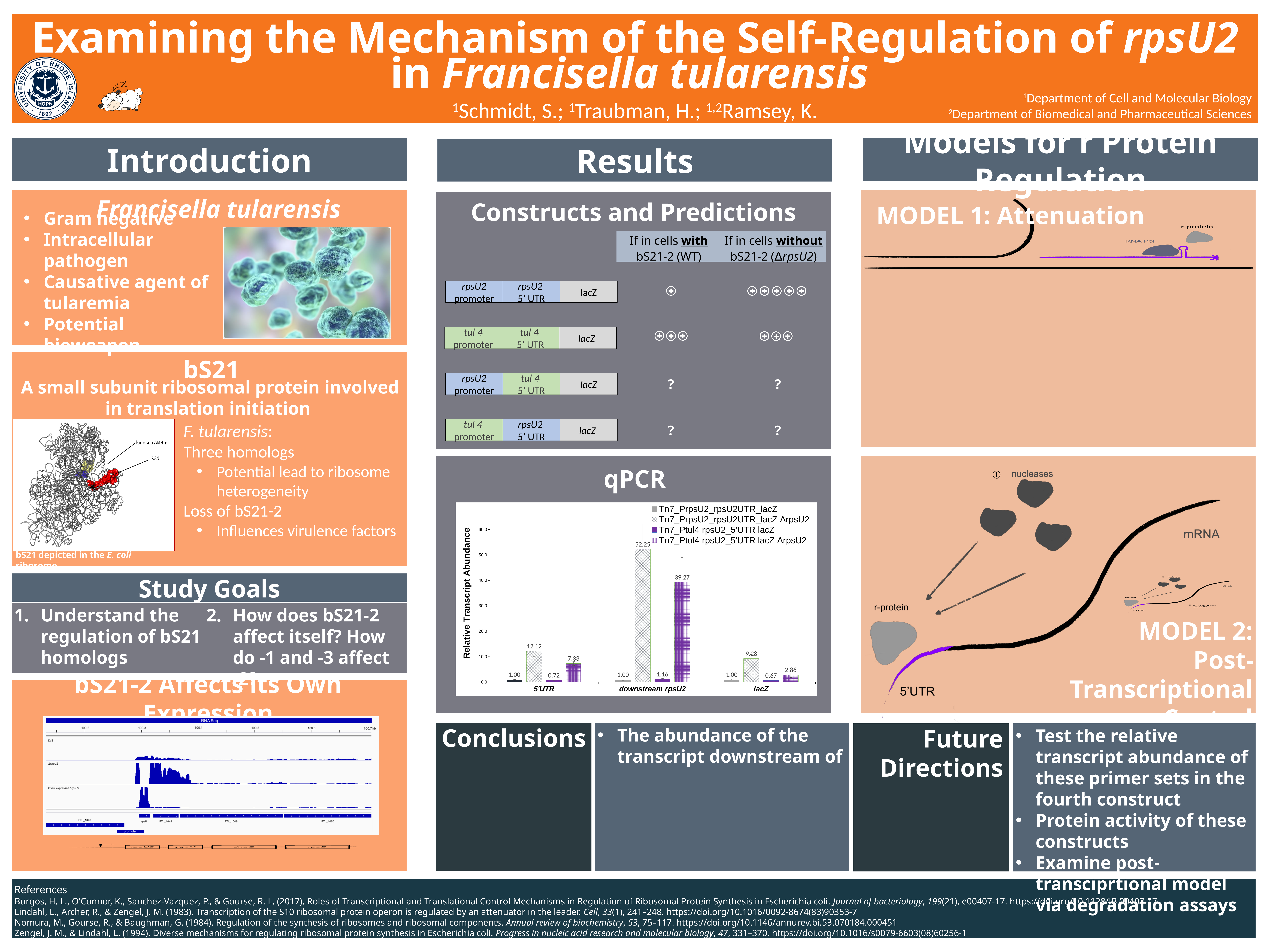
In the qPCR chart, what is the difference between the Tn7_PrpsU2_rpsU2UTR_lacZ ΔrpsU2 and Tn7_Ptul4 rpsU2_5'UTR lacZ ΔrpsU2 values at downstream rpsU2? 12.98 In the qPCR chart, which category has the lowest value for Tn7_PrpsU2_rpsU2UTR_lacZ ΔrpsU2? lacZ How many series does the legend of the qPCR chart list? 4 In the qPCR chart, is the value for Tn7_PrpsU2_rpsU2UTR_lacZ ΔrpsU2 at downstream rpsU2 greater or less than 50.0? greater In the qPCR chart, which category has the highest value for Tn7_Ptul4 rpsU2_5'UTR lacZ ΔrpsU2? downstream rpsU2 In the qPCR chart, which is larger at 5'UTR: Tn7_PrpsU2_rpsU2UTR_lacZ ΔrpsU2 or Tn7_Ptul4 rpsU2_5'UTR lacZ ΔrpsU2? Tn7_PrpsU2_rpsU2UTR_lacZ ΔrpsU2 In the qPCR chart, what is the value for Tn7_PrpsU2_rpsU2UTR_lacZ ΔrpsU2 at downstream rpsU2? 52.25 In the qPCR chart, what is the value for Tn7_Ptul4 rpsU2_5'UTR lacZ ΔrpsU2 at 5'UTR? 7.33 What kind of chart is the qPCR chart? bar chart In the qPCR chart, what is the value for Tn7_PrpsU2_rpsU2UTR_lacZ ΔrpsU2 at lacZ? 9.28 In the qPCR chart, what is the value for Tn7_Ptul4 rpsU2_5'UTR lacZ at downstream rpsU2? 1.16 How many categories are shown on the x axis of the qPCR chart? 3